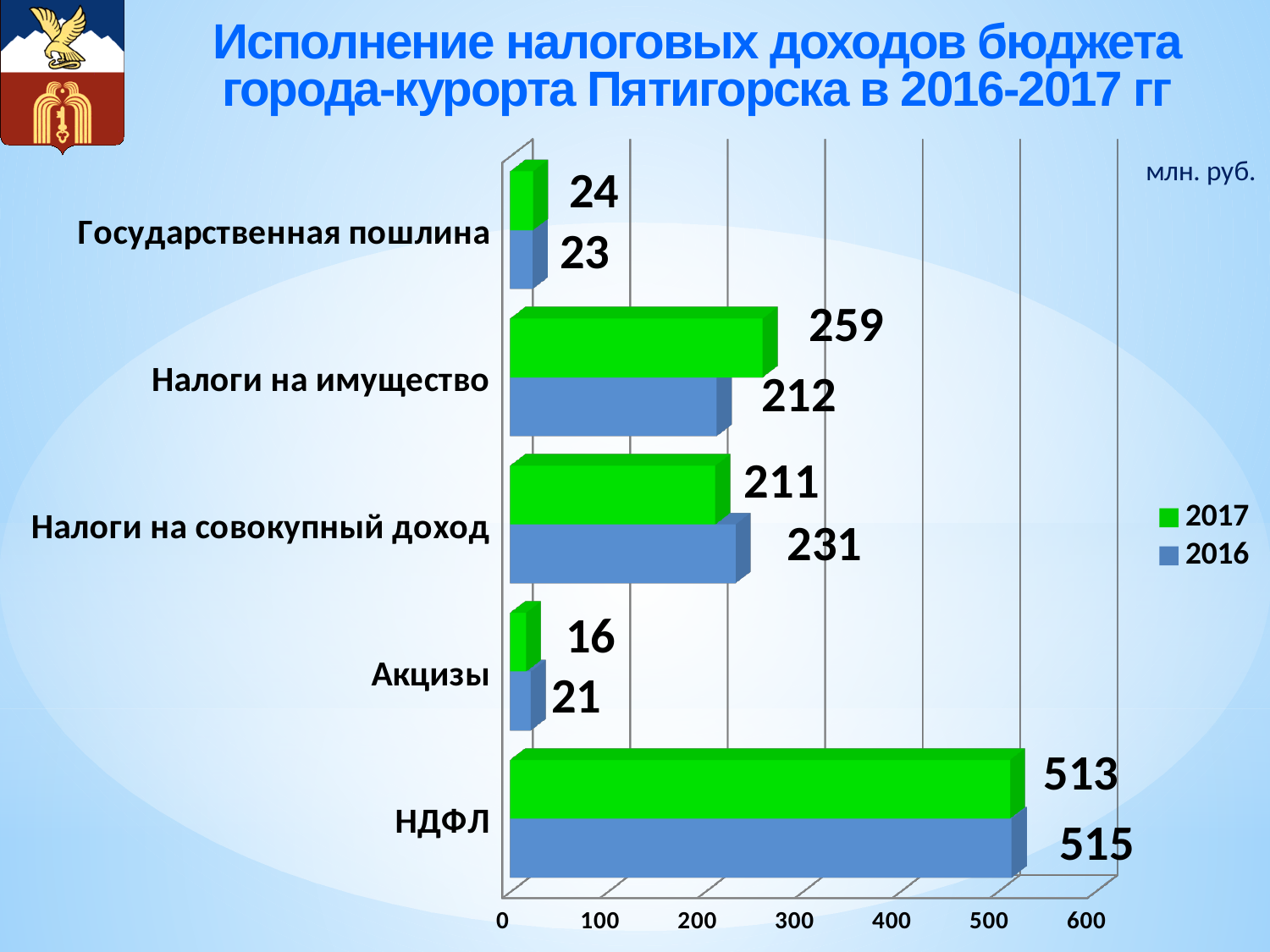
Which is larger for Акцизы: the 2016 value or the 2017 value? 2016 Which category has the highest 2016 value? НДФЛ What is the 2017 value for Акцизы? 16 What unit is indicated in the top right corner of the chart? млн. руб. What is the 2016 value for Налоги на имущество? 212 What is the difference between the 2017 and 2016 values for Налоги на имущество? 47 What kind of chart is shown on the slide? bar chart How many categories are shown on the chart? 5 What is the difference between the 2016 and 2017 values for Налоги на совокупный доход? 20 How many series does the legend list? 2 What is the 2017 value for НДФЛ? 513 Which category has the lowest 2017 value? Акцизы